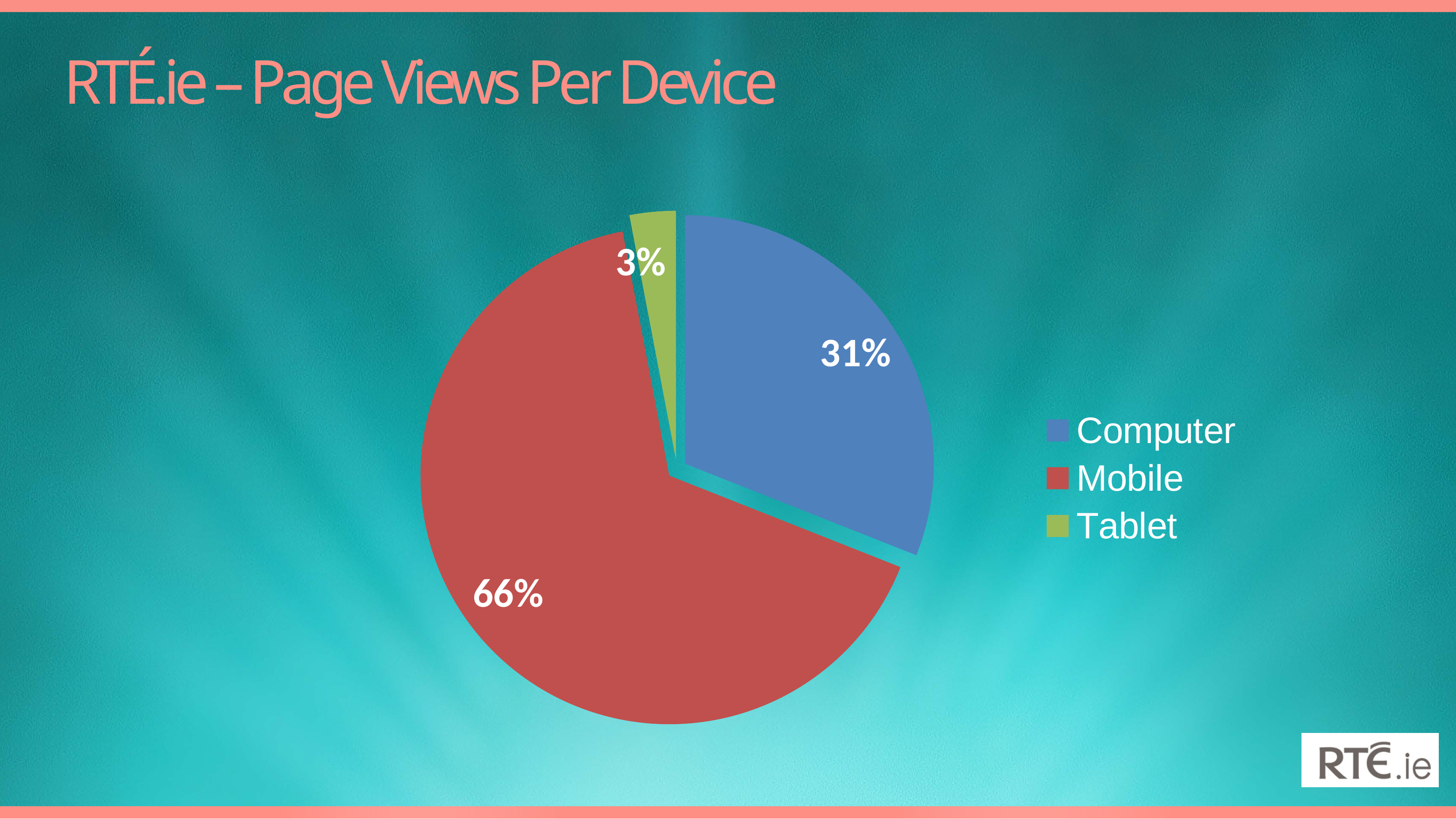
How many entries does the legend list? 3 What share of page views comes from Tablet? 3% What type of chart is shown on the slide? pie chart What is the difference in percentage points between the Mobile and Computer shares? 35 What share of page views comes from Computer? 31% What is the title of the slide? RTÉ.ie – Page Views Per Device How many device categories are shown in the pie chart? 3 Which device has the largest share of page views? Mobile Which device has the smallest share of page views? Tablet What colour is the Mobile slice? red What share of page views comes from Mobile? 66% Which has a larger share of page views, Computer or Tablet? Computer